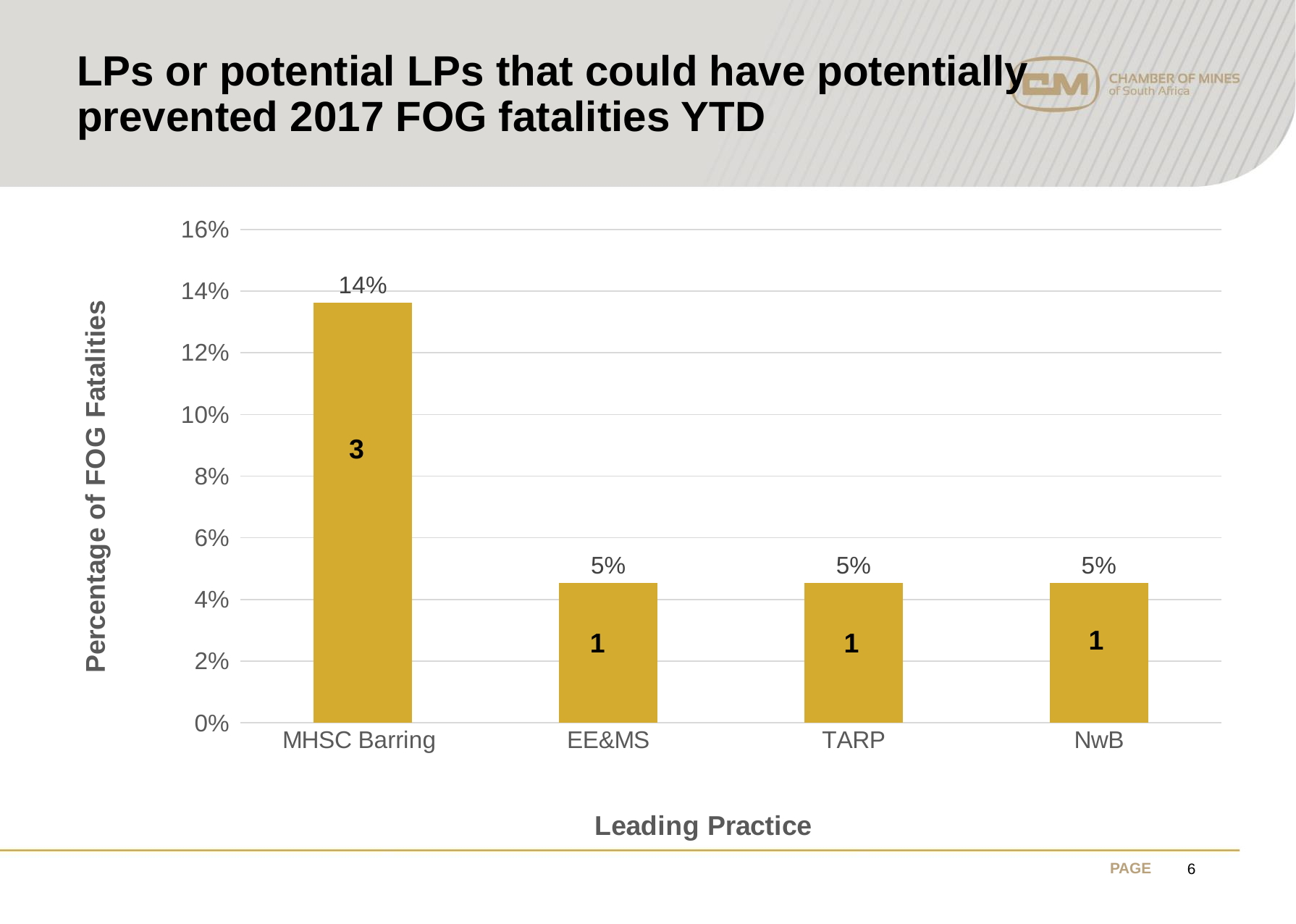
What number is printed inside the MHSC Barring bar? 3 Is the value for MHSC Barring greater or less than 12%? greater What is the label of the x axis? Leading Practice What percentage of FOG fatalities is shown for MHSC Barring? 14% What is the difference in percentage points between MHSC Barring and EE&MS? 9% What percentage of FOG fatalities is shown for TARP? 5% How many leading practices are shown on the x axis? 4 What number is printed inside the NwB bar? 1 Which leading practice has the highest percentage of FOG fatalities? MHSC Barring What kind of chart is shown on the slide? bar chart Which is larger, the value for MHSC Barring or the value for NwB? MHSC Barring Is the value for EE&MS greater or less than 6%? less